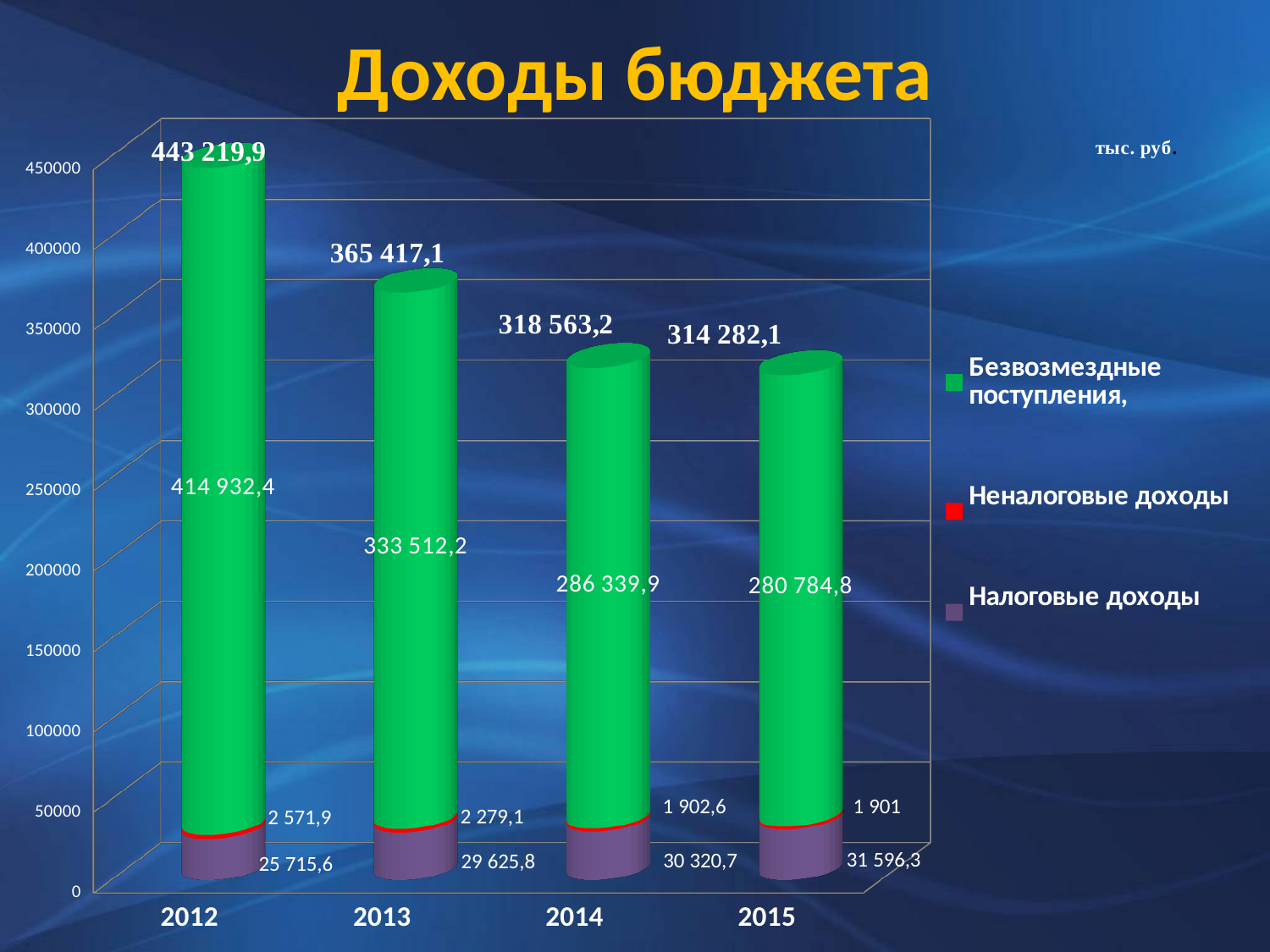
What is the total of the stacked bar for 2015? 314 282,1 Which year has the lowest value of Налоговые доходы? 2012 How many years are shown on the x axis? 4 What is the difference between the total for 2012 and the total for 2013? 77 802,8 What is the value of Налоговые доходы for 2014? 30 320,7 Which is larger: Безвозмездные поступления in 2013 or in 2014? 2013 What is the value of Неналоговые доходы for 2013? 2 279,1 What is the value of Безвозмездные поступления for 2012? 414 932,4 Do the total values rise or fall from 2012 to 2015? Fall Which year has the highest total budget income? 2012 How many series does the legend list? 3 What type of chart is shown on the slide? Stacked bar chart